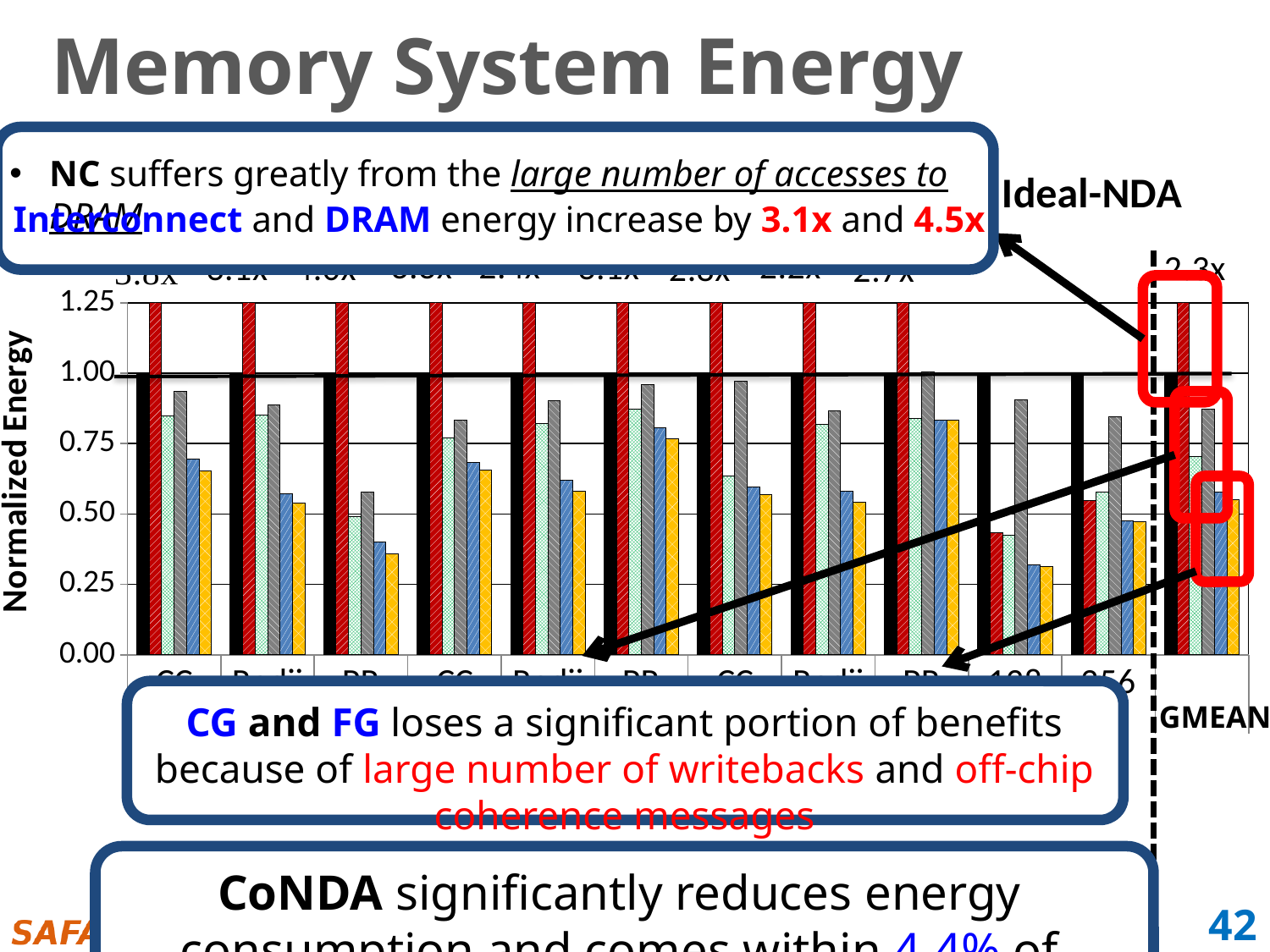
What is the highest tick value shown on the y axis? 1.25 What value does the black bar for GMEAN reach on the y axis? 1.00 What is the label on the y axis of the chart? Normalized Energy Is the value of the blue bar for the 128 group greater or less than 0.50? less Is the value of the blue bar in the first PR group greater or less than 0.50? less How many bars are plotted in each category group? 6 In the 128 group, which is taller: the grey bar or the yellow bar? grey bar Is the value of the yellow bar for GMEAN greater or less than 0.75? less What kind of chart is shown on the slide? bar chart